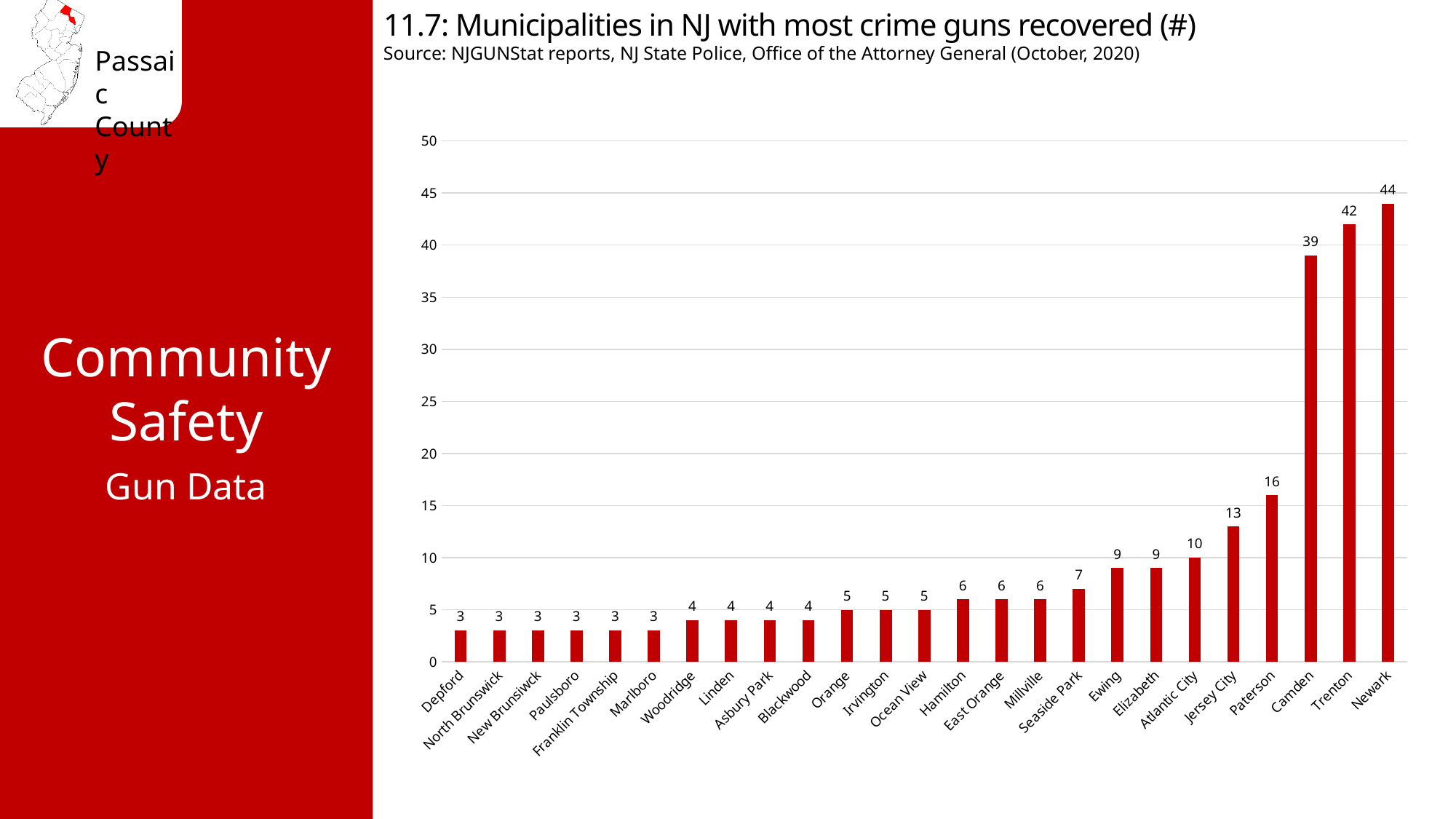
Which municipality has the highest number of crime guns recovered? Newark Which has a larger value, Jersey City or Elizabeth? Jersey City What is the difference between the values for Newark and Trenton? 2 What is the number of crime guns recovered in Atlantic City? 10 Which has a larger value, Seaside Park or Hamilton? Seaside Park What kind of chart is shown on the slide? Bar chart What is the number of crime guns recovered in Paterson? 16 Is the value for Trenton greater or less than 40? greater What is the number of crime guns recovered in Camden? 39 What is the difference between the values for Camden and Paterson? 23 Do the values rise or fall from left to right along the x axis? Rise How many municipalities are shown on the chart? 25